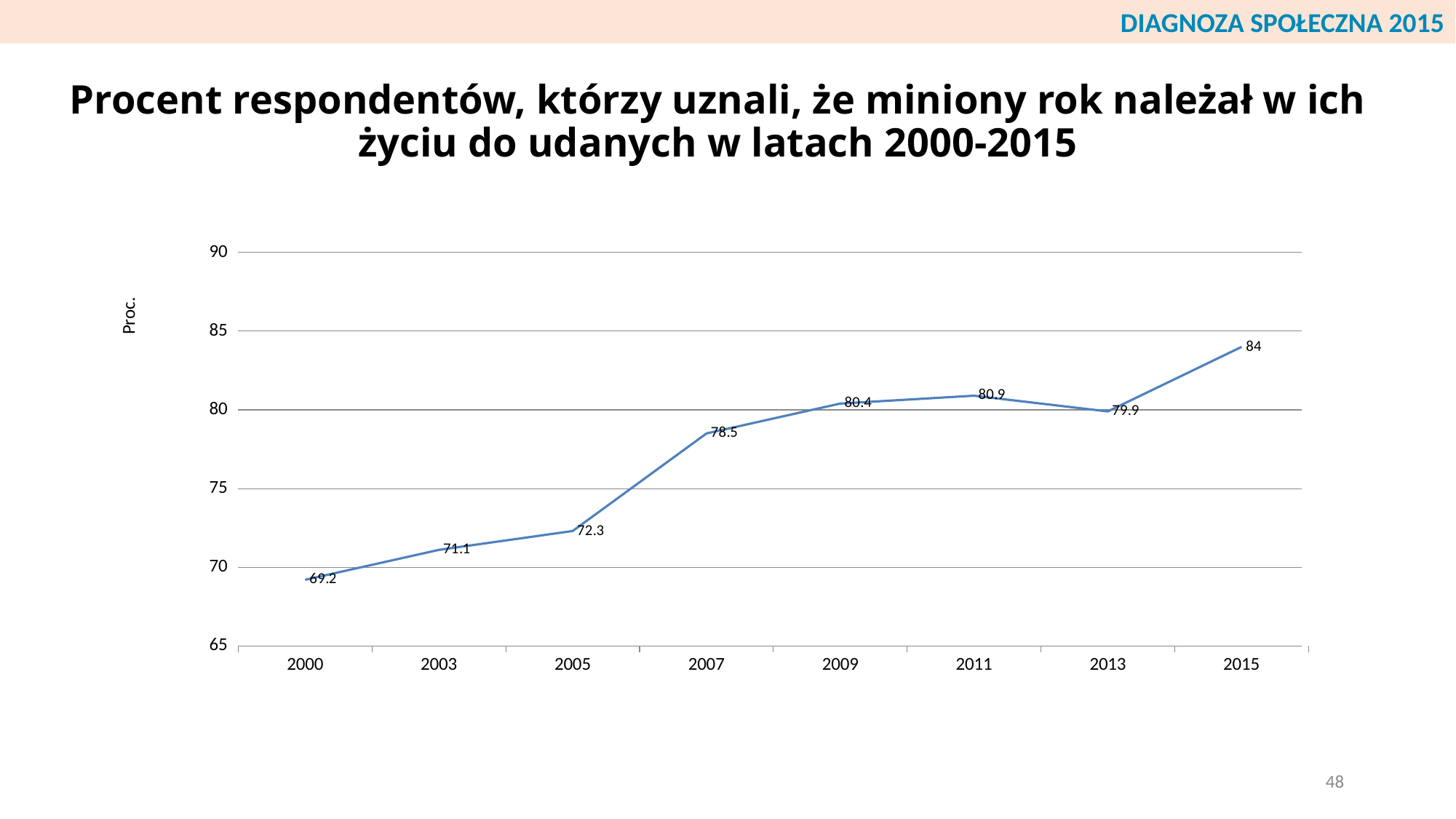
What is the difference between the values for 2011 and 2013? 1 Which is larger, the value for 2009 or the value for 2013? 2009 How many years are plotted on the chart? 8 What is the value for 2015? 84 What kind of chart is shown on the slide? line chart What is the difference between the values for 2015 and 2000? 14.8 Which year has the highest value? 2015 Which year has the lowest value? 2000 Is the value for 2005 greater or less than 75? less What is the value for 2000? 69.2 What is the value for 2007? 78.5 What is the label on the vertical axis? Proc.